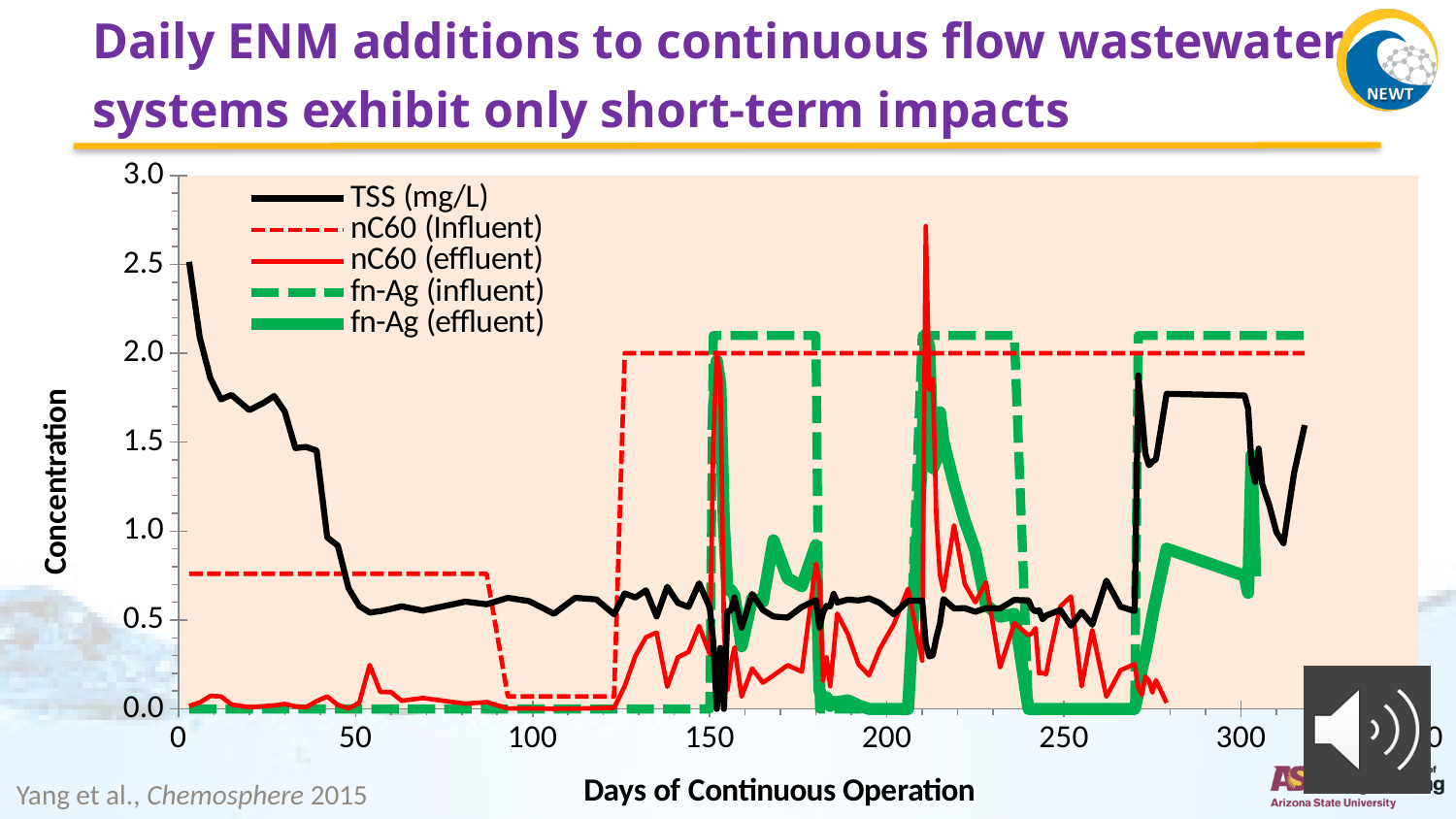
Which series reaches the highest peak value on the chart? nC60 (effluent) At day 100, which is larger: TSS (mg/L) or nC60 (Influent)? TSS (mg/L) What kind of chart is shown on the slide? line chart What are the series names listed in the chart's legend? TSS (mg/L), nC60 (Influent), nC60 (effluent), fn-Ag (influent), fn-Ag (effluent) Does the TSS (mg/L) series rise or fall over the first 50 days of operation? fall Is the TSS (mg/L) value at day 0 greater or less than 2.0? greater Is the fn-Ag (influent) value between days 150 and 180 greater or less than 1.5? greater Is the nC60 (Influent) value during the first 50 days greater or less than 1.0? less What is the title of the chart's x axis? Days of Continuous Operation How many series does the chart's legend list? 5